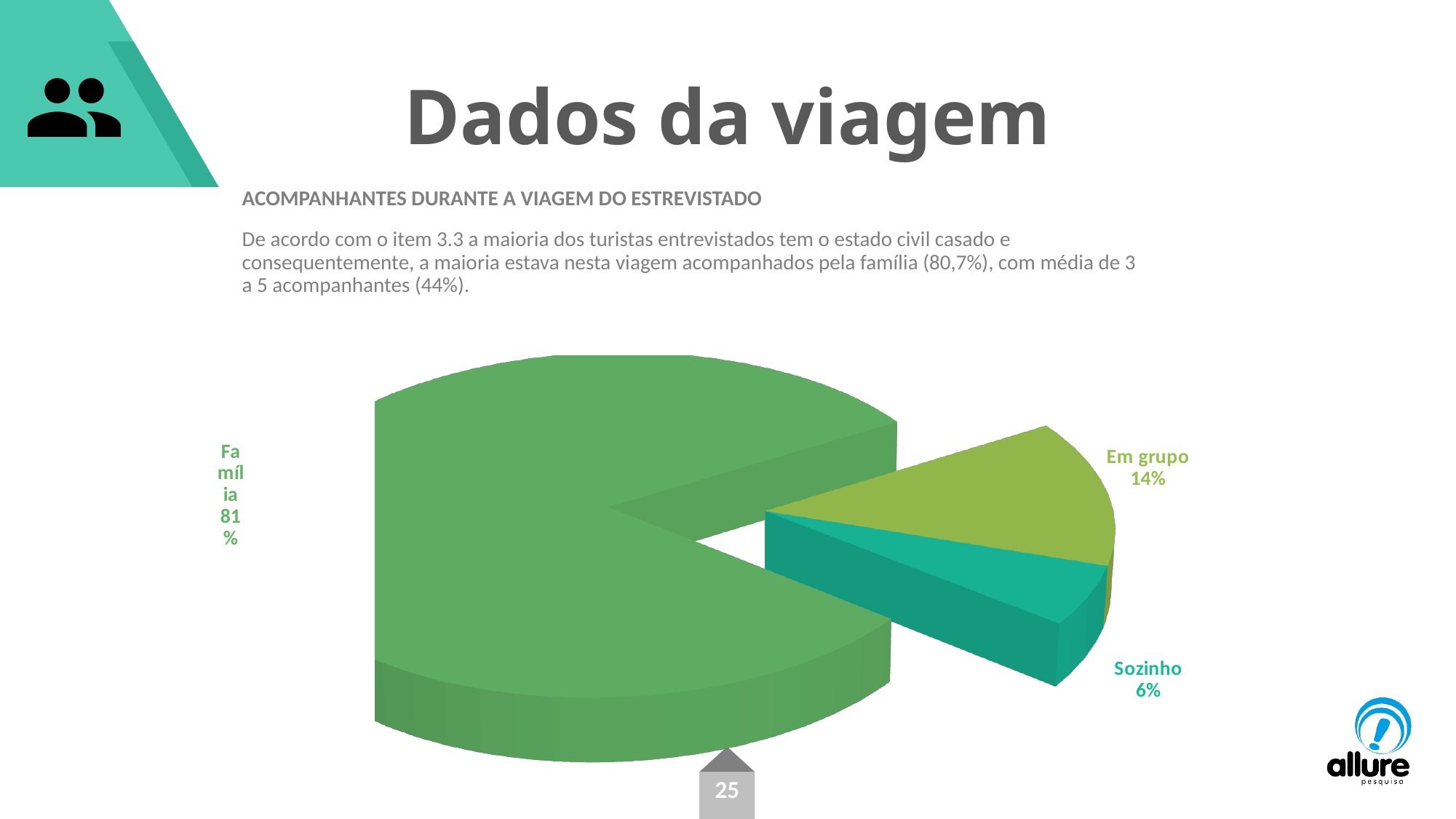
What share of the pie does Sozinho represent? 6% What is the difference in percentage points between Em grupo and Sozinho? 8 Which is larger, the share for Em grupo or the share for Sozinho? Em grupo How many categories are shown in the pie chart? 3 What is the difference in percentage points between Família and Em grupo? 67 What share of the pie does Família represent? 81% What share of the pie does Em grupo represent? 14% What kind of chart is shown on the slide? Pie chart What is the heading printed above the chart? ACOMPANHANTES DURANTE A VIAGEM DO ESTREVISTADO Which category has the largest slice of the pie? Família What is the combined share of Em grupo and Sozinho? 20% Which category has the smallest slice of the pie? Sozinho